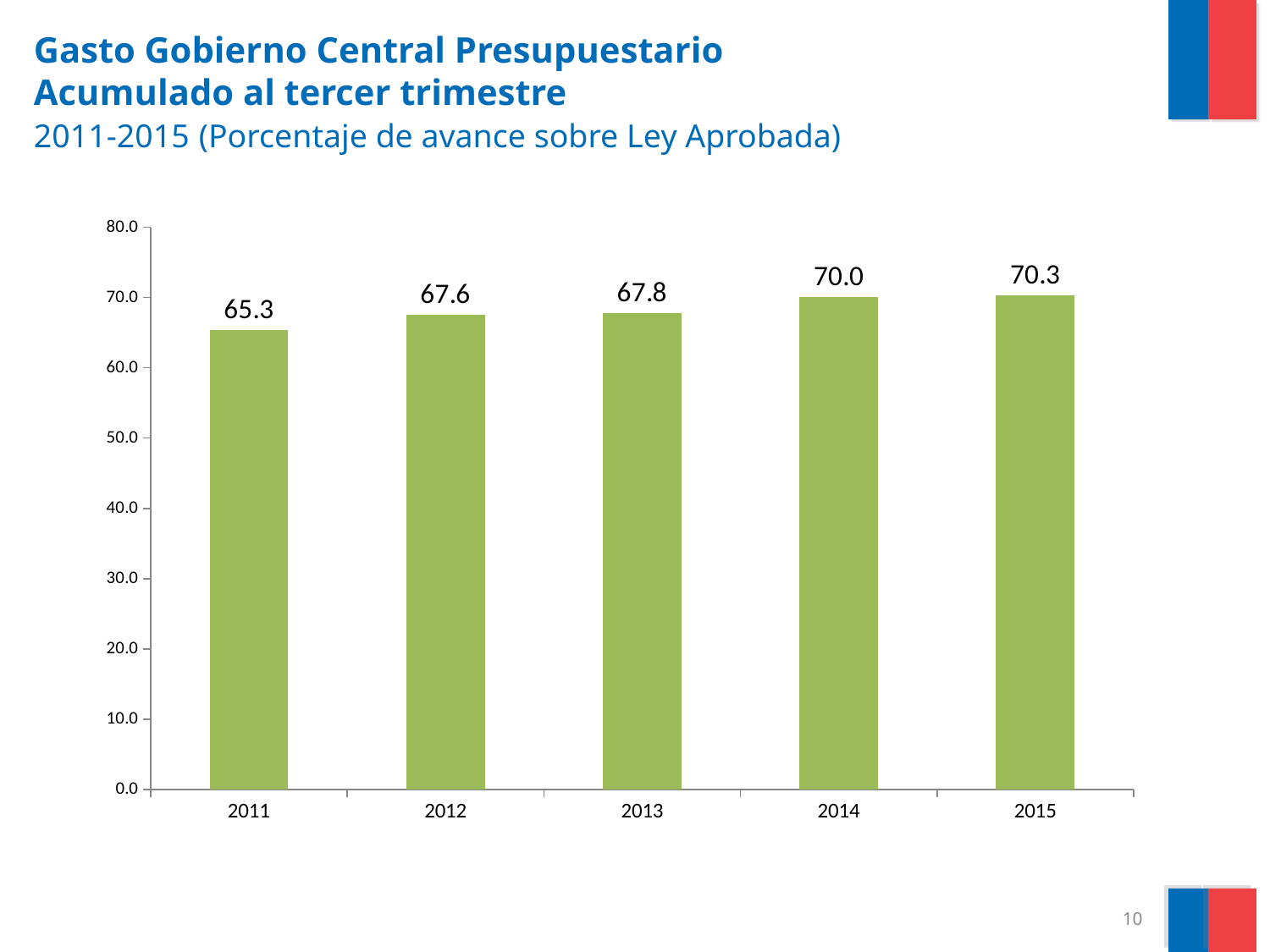
How many years are shown on the chart? 5 Which year has the highest value? 2015 What is the difference between the values for 2014 and 2012? 2.4 Which year has the lowest value? 2011 Is the value for 2011 greater or less than 70.0? less What kind of chart is shown on the slide? bar chart Which is larger, the value for 2012 or the value for 2014? 2014 What is the value for 2011? 65.3 What is the value for 2015? 70.3 What is the difference between the values for 2015 and 2011? 5.0 What is the value for 2013? 67.8 Do the values rise or fall from 2011 to 2015? rise